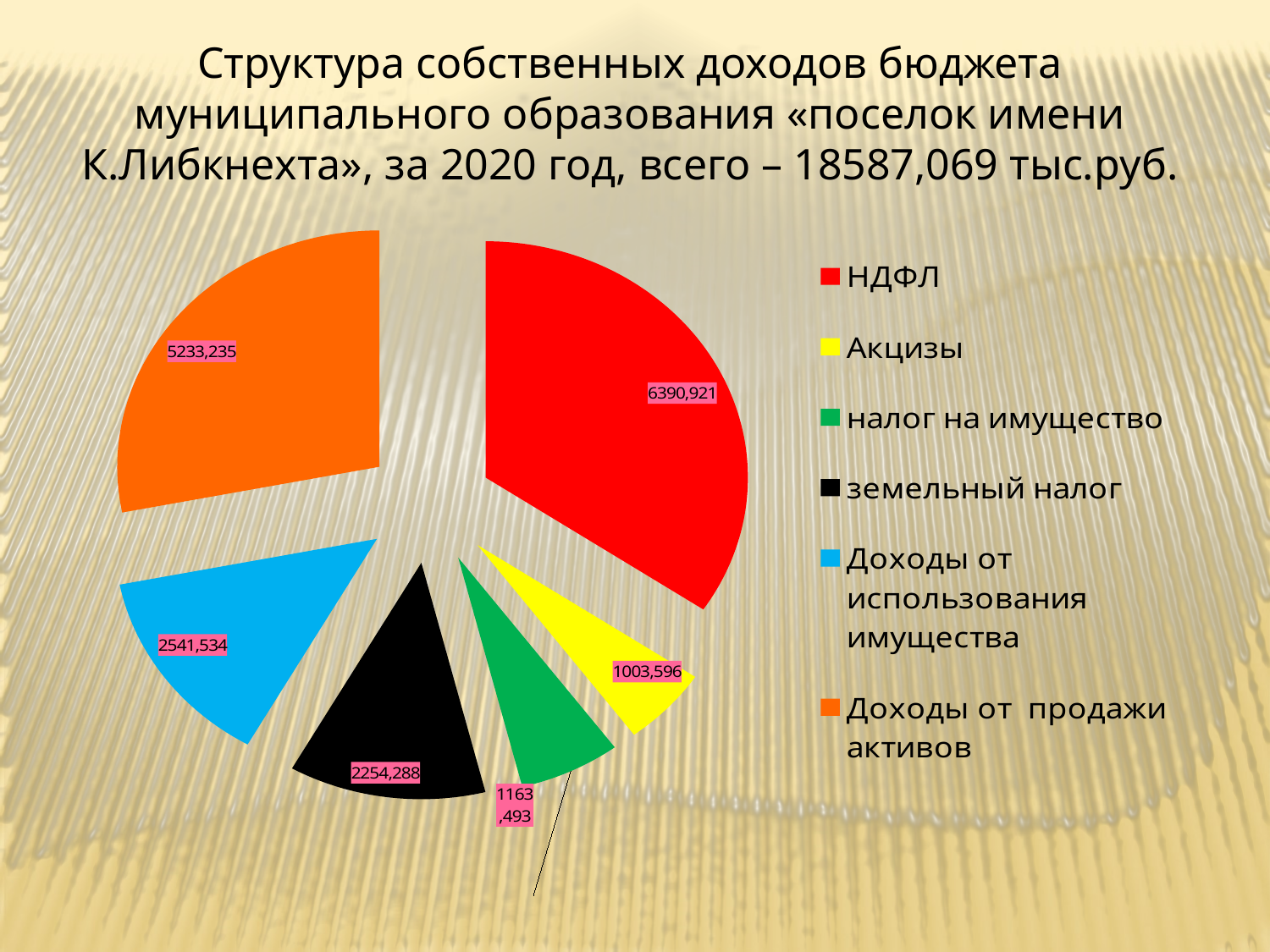
What is the value shown for НДФЛ? 6390,921 What is the value shown for Акцизы? 1003,596 Which category has the smallest slice of the pie? Акцизы What is the value shown for земельный налог? 2254,288 How many slices does the pie chart have? 6 What kind of chart is shown on the slide? pie chart Which category has the largest slice of the pie? НДФЛ What is the difference between the values for НДФЛ and Доходы от продажи активов? 1157,686 How many entries does the legend list? 6 What colour is the slice for Доходы от продажи активов? orange What is the value shown for Доходы от использования имущества? 2541,534 Which is larger, the value for налог на имущество or the value for Акцизы? налог на имущество